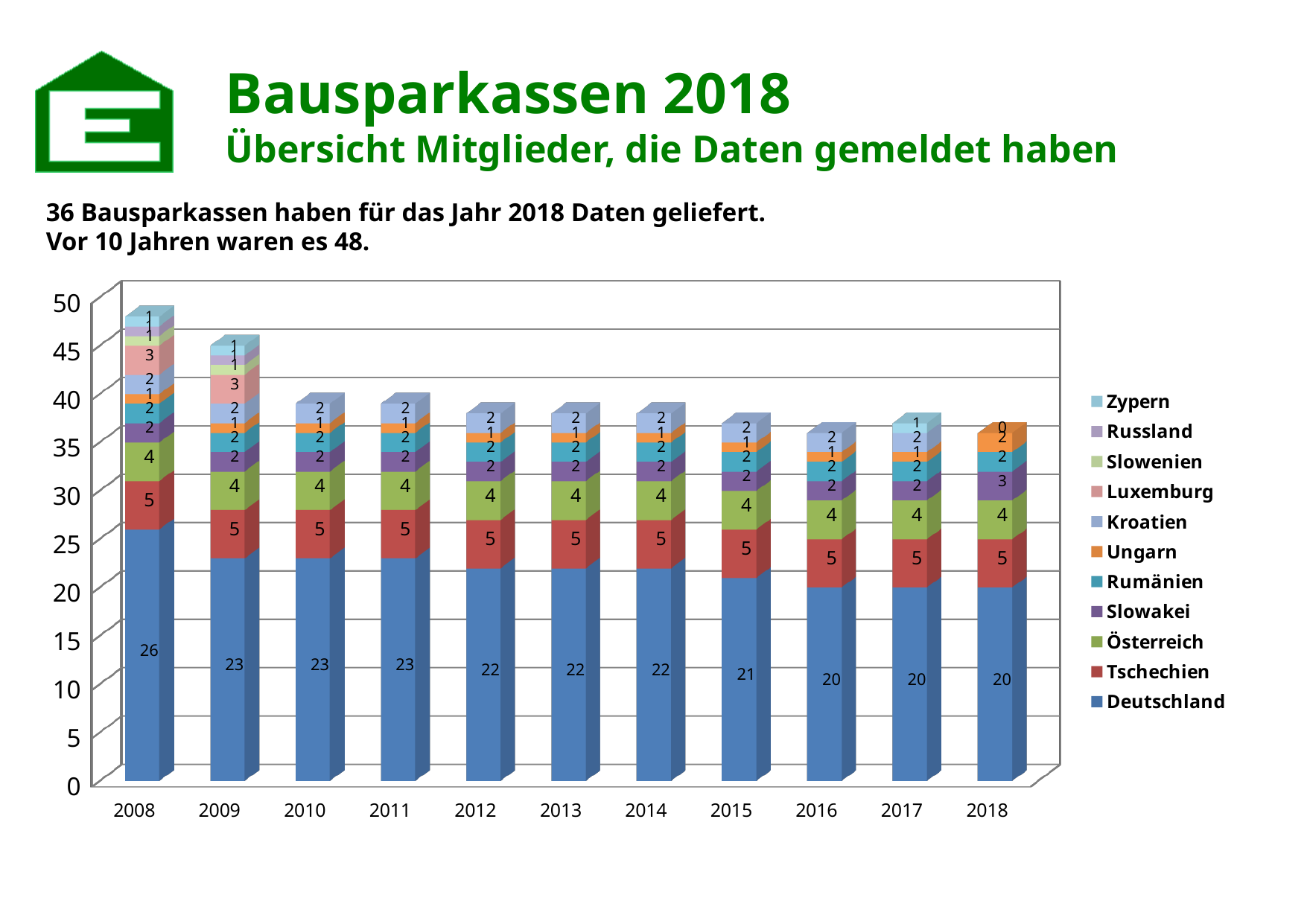
What is the value for Tschechien in 2015? 5 In which year is the value for Deutschland highest? 2008 What kind of chart is shown on the slide? Stacked bar chart What is the value for Deutschland in 2008? 26 How many series does the chart legend list? 11 Does the value for Deutschland rise or fall from 2008 to 2018? Fall Is the total of the stacked bar for 2010 greater or less than 35? greater How many years are shown on the x axis of the chart? 11 What is the difference between the Deutschland value in 2008 and in 2018? 6 What is the value for Slowakei in 2018? 3 What is the value for Deutschland in 2018? 20 What is the total of the stacked bar for 2018? 36